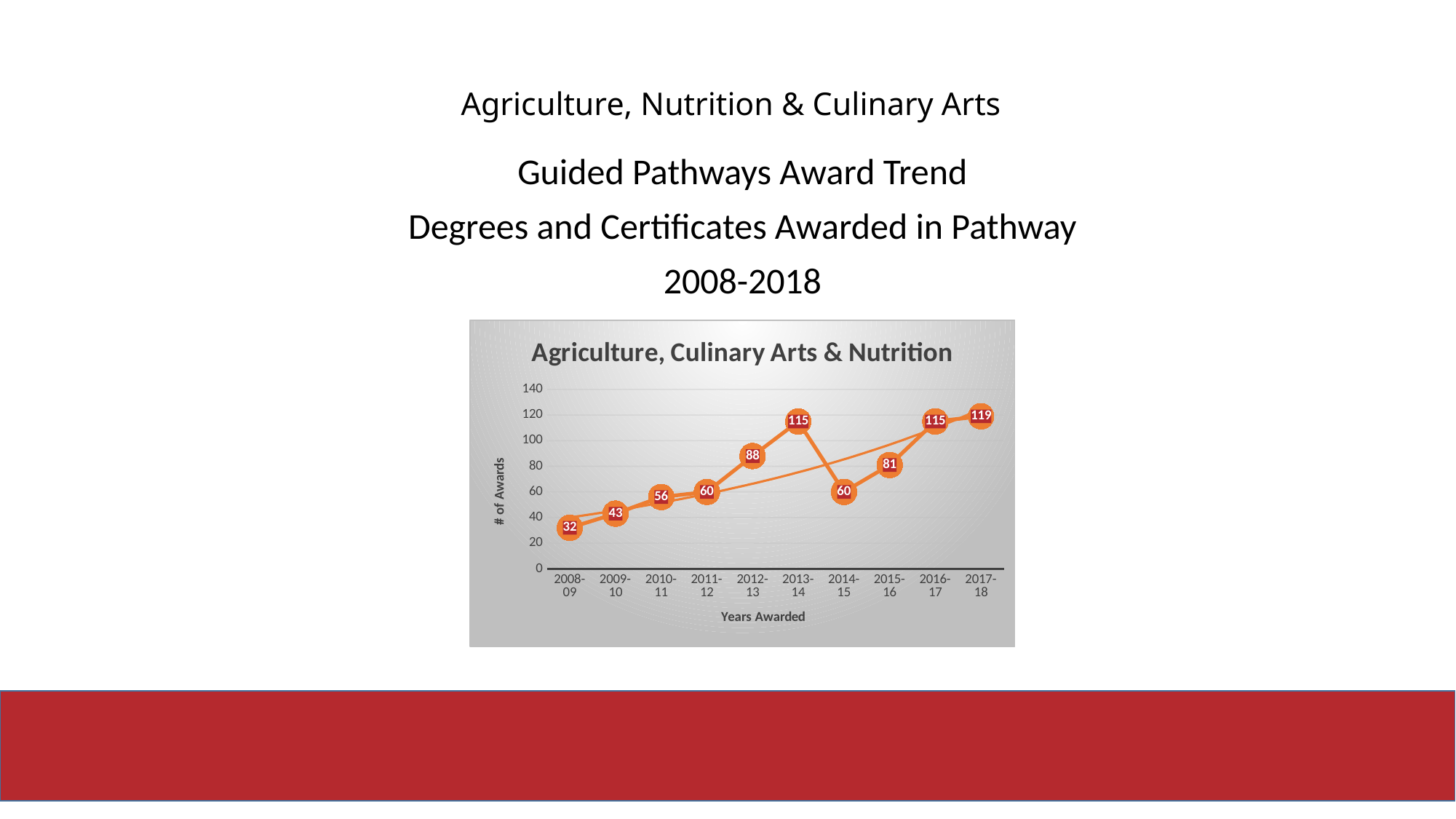
Do the values generally rise or fall from 2008-09 to 2017-18? rise What is the title of the chart? Agriculture, Culinary Arts & Nutrition What is the value for 2013-14? 115 Which year has the highest number of awards? 2017-18 What kind of chart is shown? line chart What is the difference between the values for 2013-14 and 2014-15? 55 What is the value for 2015-16? 81 Which year has the lowest number of awards? 2008-09 Is the value for 2016-17 greater or less than 100? greater Which is larger, the value for 2012-13 or the value for 2015-16? 2012-13 How many years are plotted on the x axis? 10 What is the value for 2008-09? 32